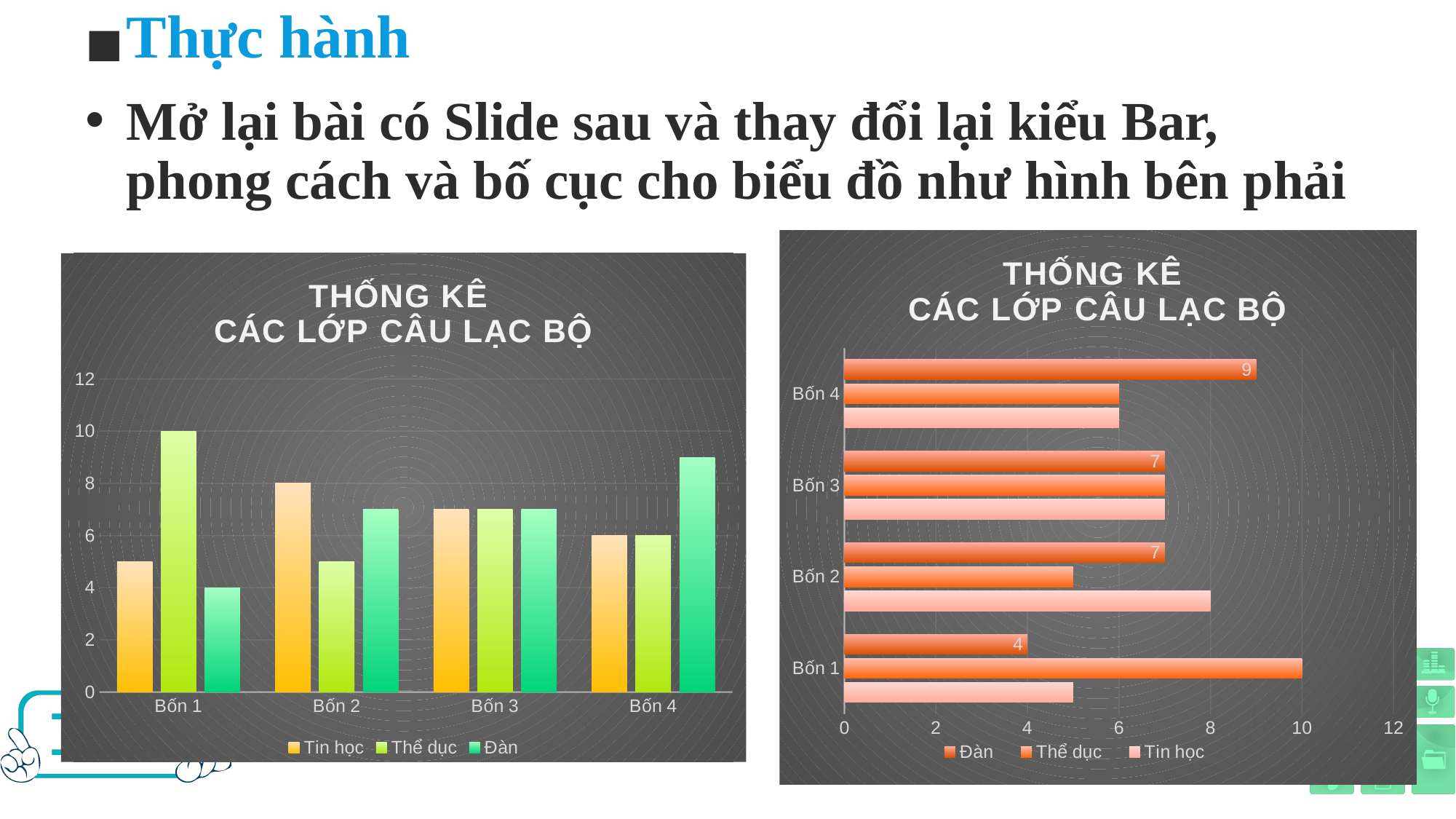
What is the title of the chart on the right? THỐNG KÊ CÁC LỚP CÂU LẠC BỘ In the chart on the left, is the value of Đàn for Bốn 4 greater or less than 8? greater In the chart on the right, what is the value of Đàn for Bốn 4? 9 What kind of chart is the chart on the left of the slide? bar chart In the chart on the right, what is the value of Đàn for Bốn 1? 4 How many series does the legend of the chart on the right list? 3 In the chart on the left, what is the value of Thể dục for Bốn 1? 10 In the chart on the left, which is larger for Bốn 1: Thể dục or Đàn? Thể dục How many categories are shown on the x axis of the chart on the left? 4 In the chart on the right, which category has the lowest Đàn value? Bốn 1 In the chart on the right, what is the difference between the Đàn values for Bốn 4 and Bốn 1? 5 In the chart on the right, which category has the highest Đàn value? Bốn 4